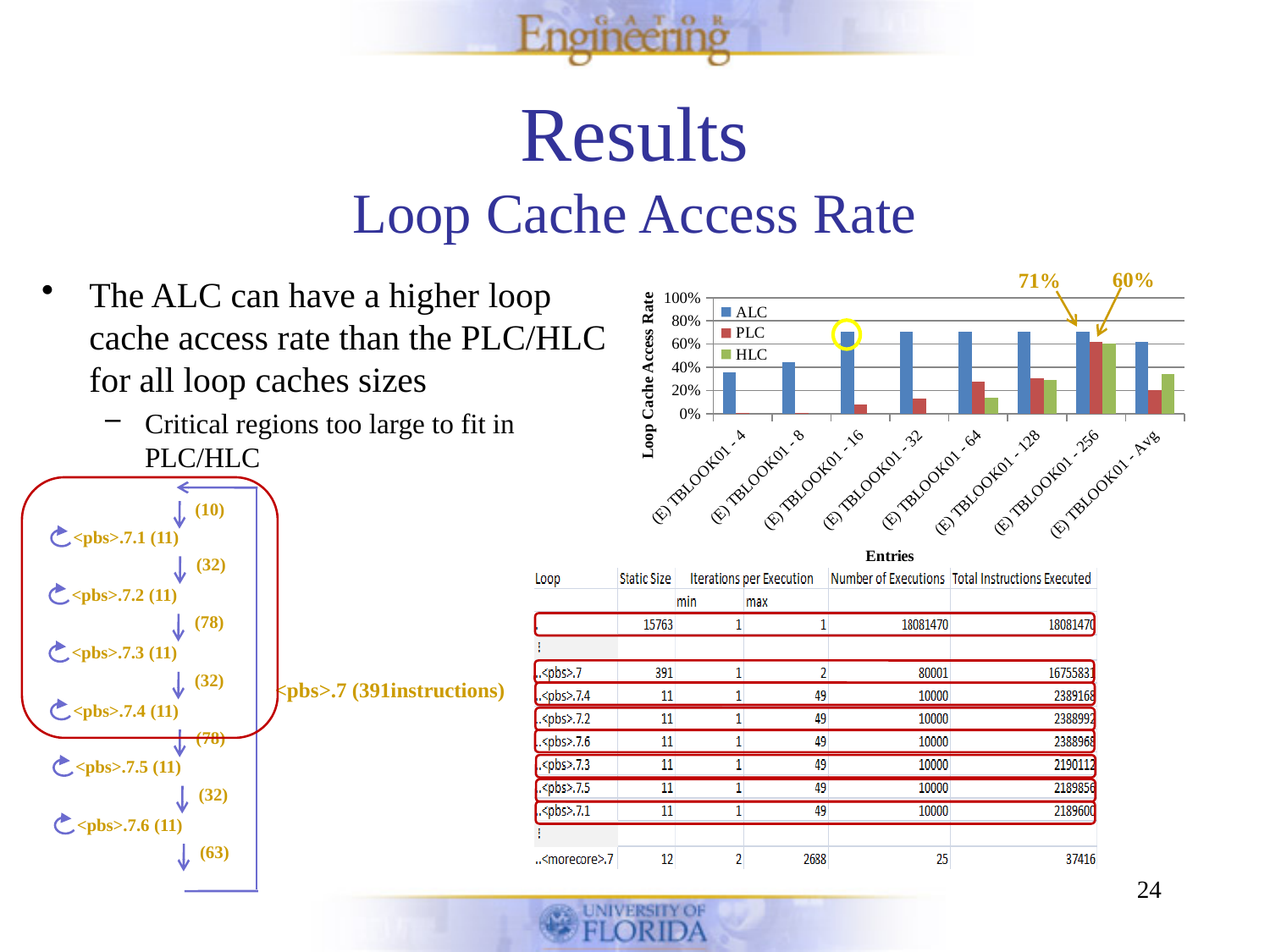
What is the PLC loop cache access rate for (E) TBLOOK01 - 256, as annotated on the chart? 60% Is the HLC value for (E) TBLOOK01 - 64 greater or less than 20%? less Is the ALC value for (E) TBLOOK01 - 16 greater or less than 60%? greater What is the difference between the annotated ALC and PLC values for (E) TBLOOK01 - 256? 11% How many categories are shown along the x axis of the chart? 8 Which series has the highest value for (E) TBLOOK01 - 256? ALC How many series does the chart legend list? 3 What is the ALC loop cache access rate for (E) TBLOOK01 - 256, as annotated on the chart? 71% Which is larger, the ALC value for (E) TBLOOK01 - 4 or the ALC value for (E) TBLOOK01 - 16? (E) TBLOOK01 - 16 What kind of chart is shown on the slide? bar chart What is the title of the chart's vertical axis? Loop Cache Access Rate Does the ALC value rise or fall from (E) TBLOOK01 - 4 to (E) TBLOOK01 - 16? rise